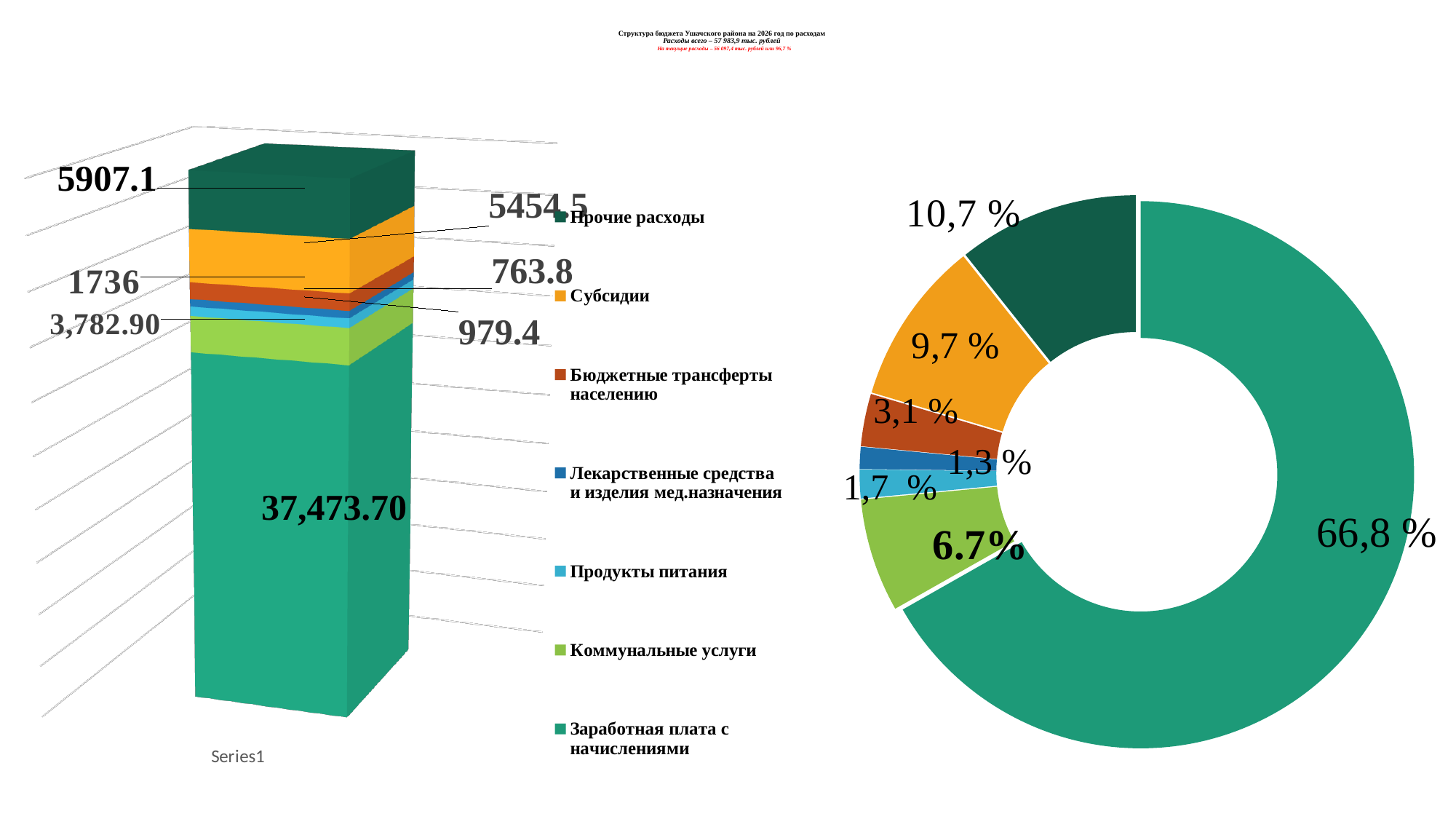
In the doughnut chart on the right, what share is shown for Заработная плата с начислениями? 66,8 % In the bar chart on the left, what is the difference between the values 5907.1 and 5454.5? 452.6 In the doughnut chart on the right, what share is shown for Коммунальные услуги? 6.7% What kind of chart is on the left side of the slide? bar chart In the bar chart on the left, what value is labelled on the top segment, Прочие расходы? 5907.1 In the doughnut chart on the right, which category has the smallest share? Лекарственные средства и изделия мед.назначения In the bar chart on the left, what value is labelled on the largest segment, Заработная плата с начислениями? 37,473.70 In the doughnut chart on the right, which category has the largest share? Заработная плата с начислениями In the doughnut chart on the right, what share is shown for Прочие расходы? 10,7 % What kind of chart is on the right side of the slide? doughnut chart How many categories does the legend between the two charts list? 7